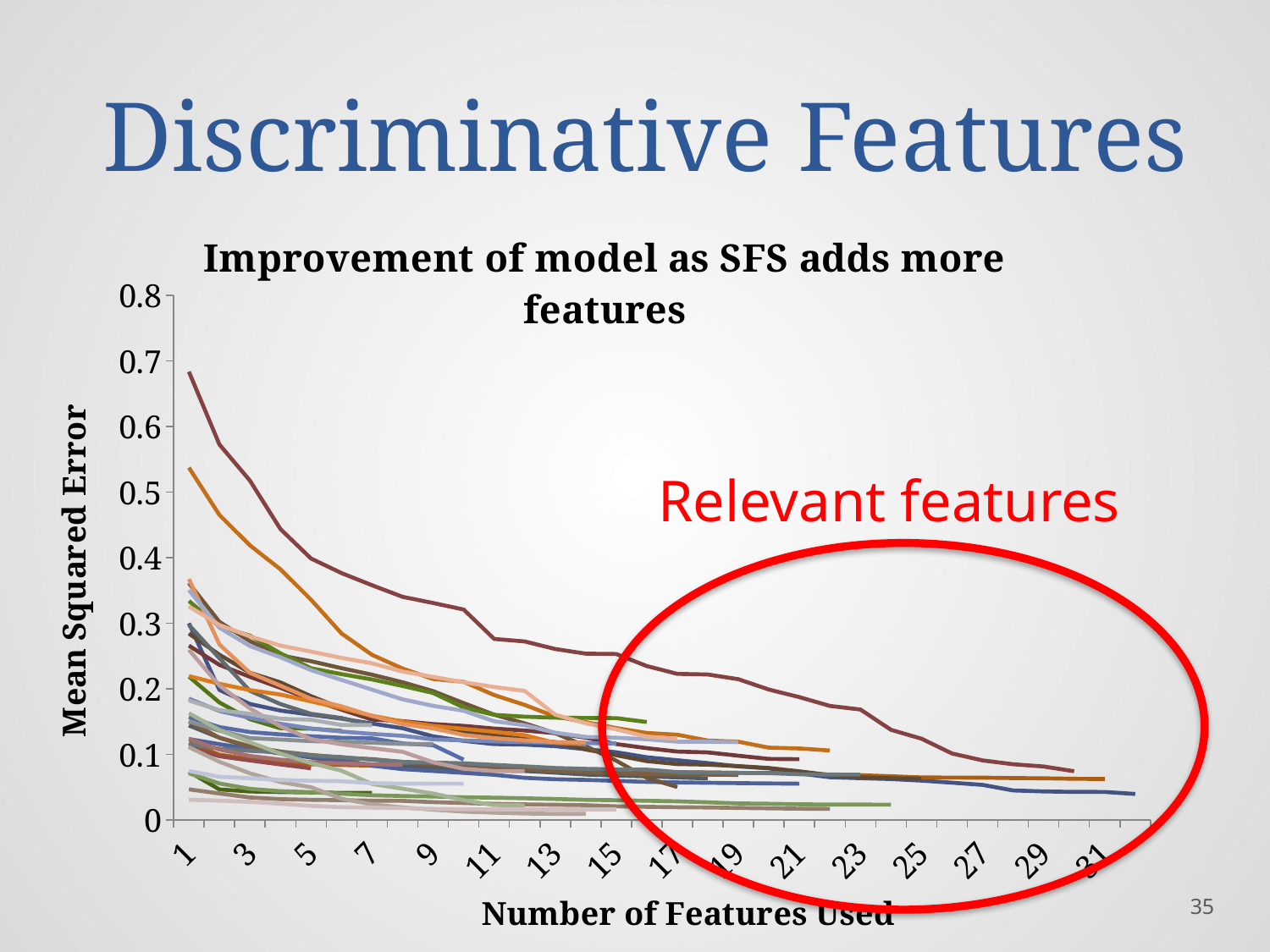
What is the label of the vertical axis? Mean Squared Error Which number of features used has the higher mean squared error for the topmost line: 3 or 9? 3 Do the lines generally rise or fall as the number of features used increases? fall Is the highest mean squared error at 1 feature used greater or less than 0.6? greater Is the mean squared error of the topmost line at 25 features used greater or less than 0.2? less What is the title of the chart? Improvement of model as SFS adds more features What kind of chart is shown on the slide? line chart Is the mean squared error of the topmost line at 15 features used greater or less than 0.2? greater What is the lowest value shown on the vertical axis? 0